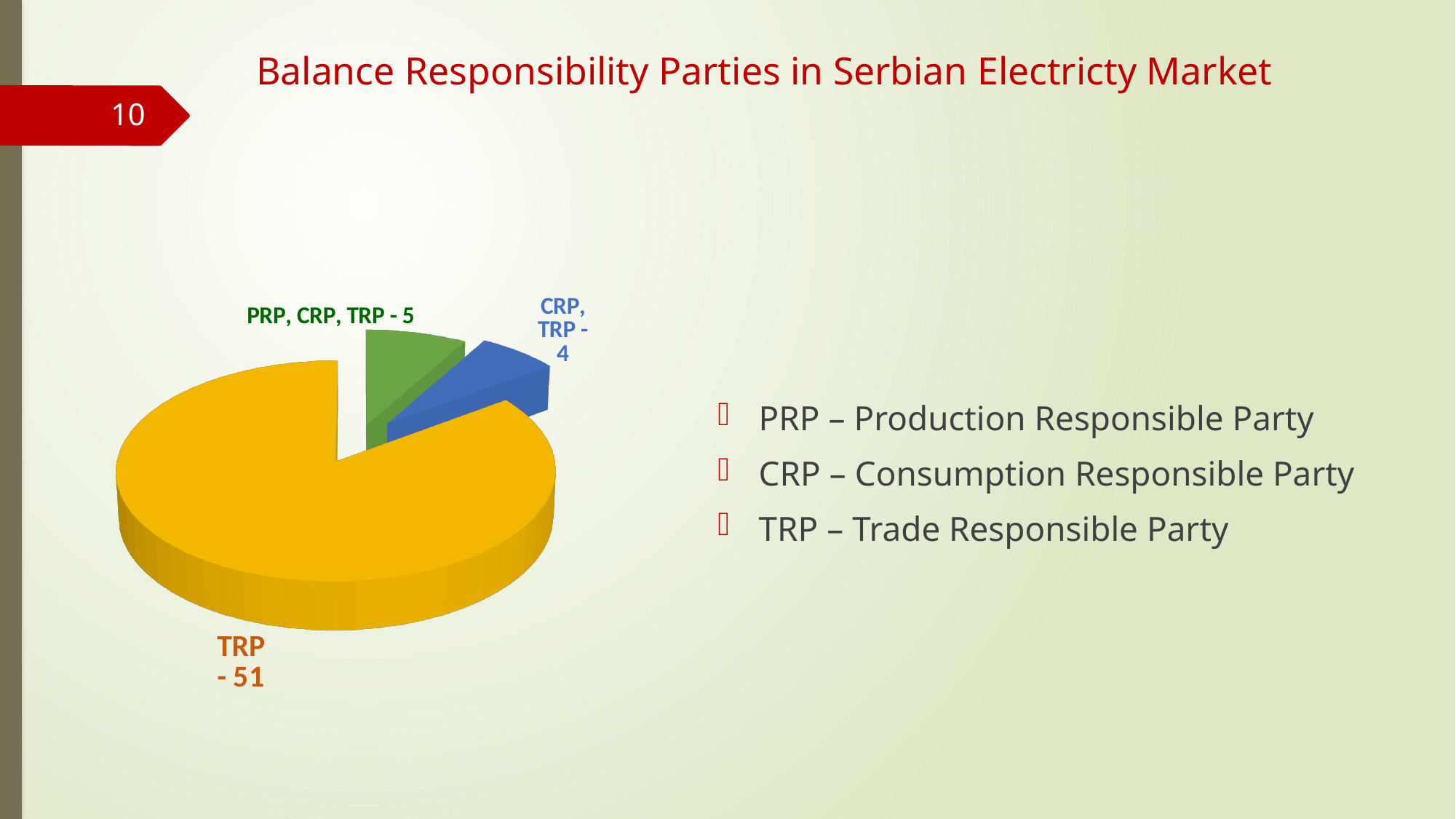
Which is larger, the PRP, CRP, TRP slice or the CRP, TRP slice? PRP, CRP, TRP What share of the pie does the TRP slice represent? 85% What is the value of the TRP slice in the pie chart? 51 What is the difference between the TRP slice and the PRP, CRP, TRP slice? 46 How many slices does the pie chart have? 3 What is the value of the CRP, TRP slice in the pie chart? 4 What is the difference between the PRP, CRP, TRP slice and the CRP, TRP slice? 1 What is the value of the PRP, CRP, TRP slice in the pie chart? 5 What kind of chart is shown on the slide? pie chart What is the total of all slices in the pie chart? 60 Which slice of the pie chart is the smallest? CRP, TRP Which slice of the pie chart is the largest? TRP